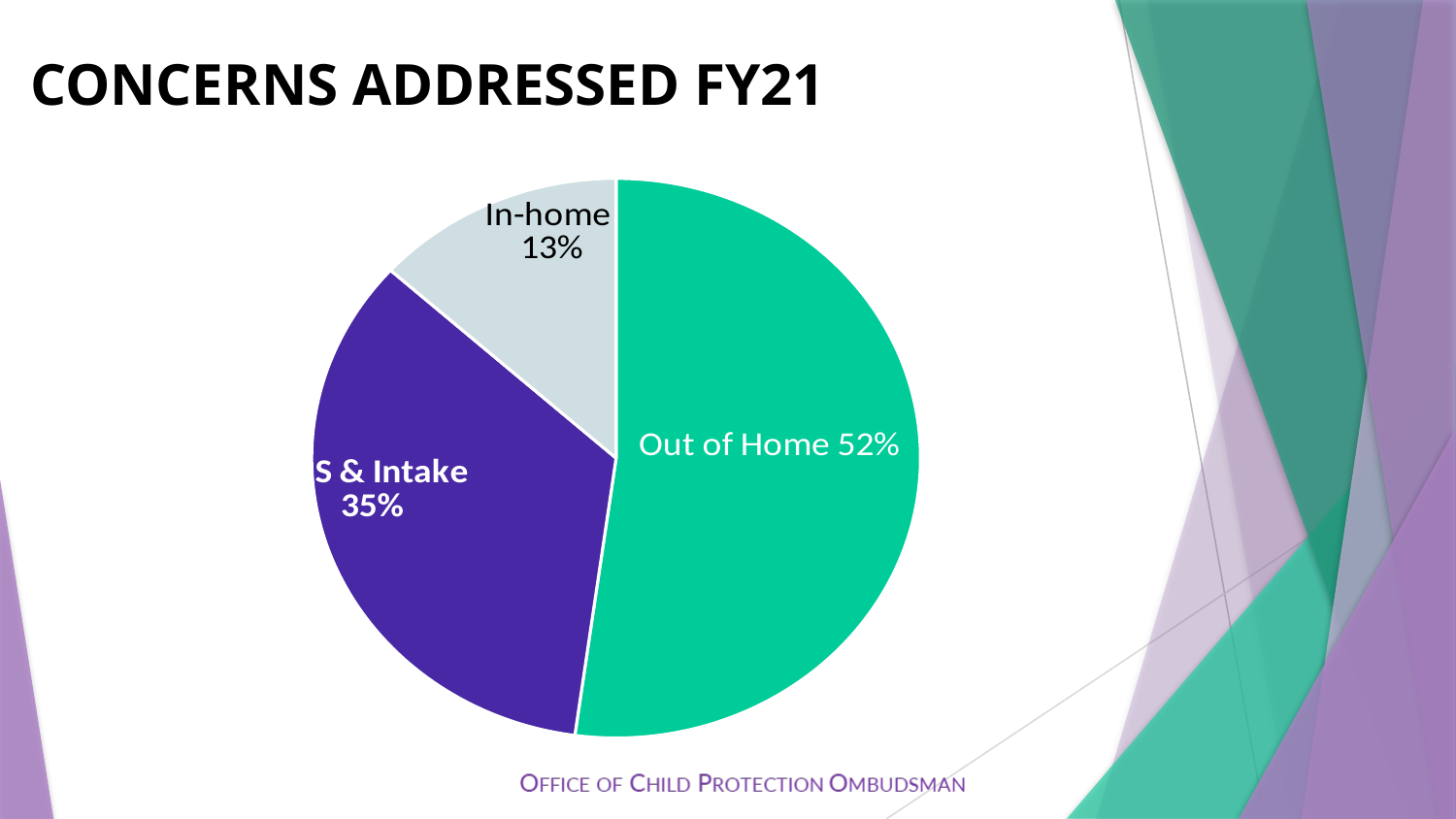
What is the chart's title? CONCERNS ADDRESSED FY21 What percentage of concerns addressed is labelled In-home? 13% How many percentage points larger is the Out of Home slice than the In-home slice? 39 Which slice of the pie is the largest? Out of Home Which is larger, the Out of Home slice or the In-home slice? Out of Home What percentage is shown on the purple slice of the pie? 35% What percentage of concerns addressed is labelled Out of Home? 52% Which slice of the pie is the smallest? In-home What colour is the Out of Home slice? green How many percentage points larger is the purple slice than the In-home slice? 22 How many slices does the pie chart have? 3 What kind of chart is shown on the slide? pie chart